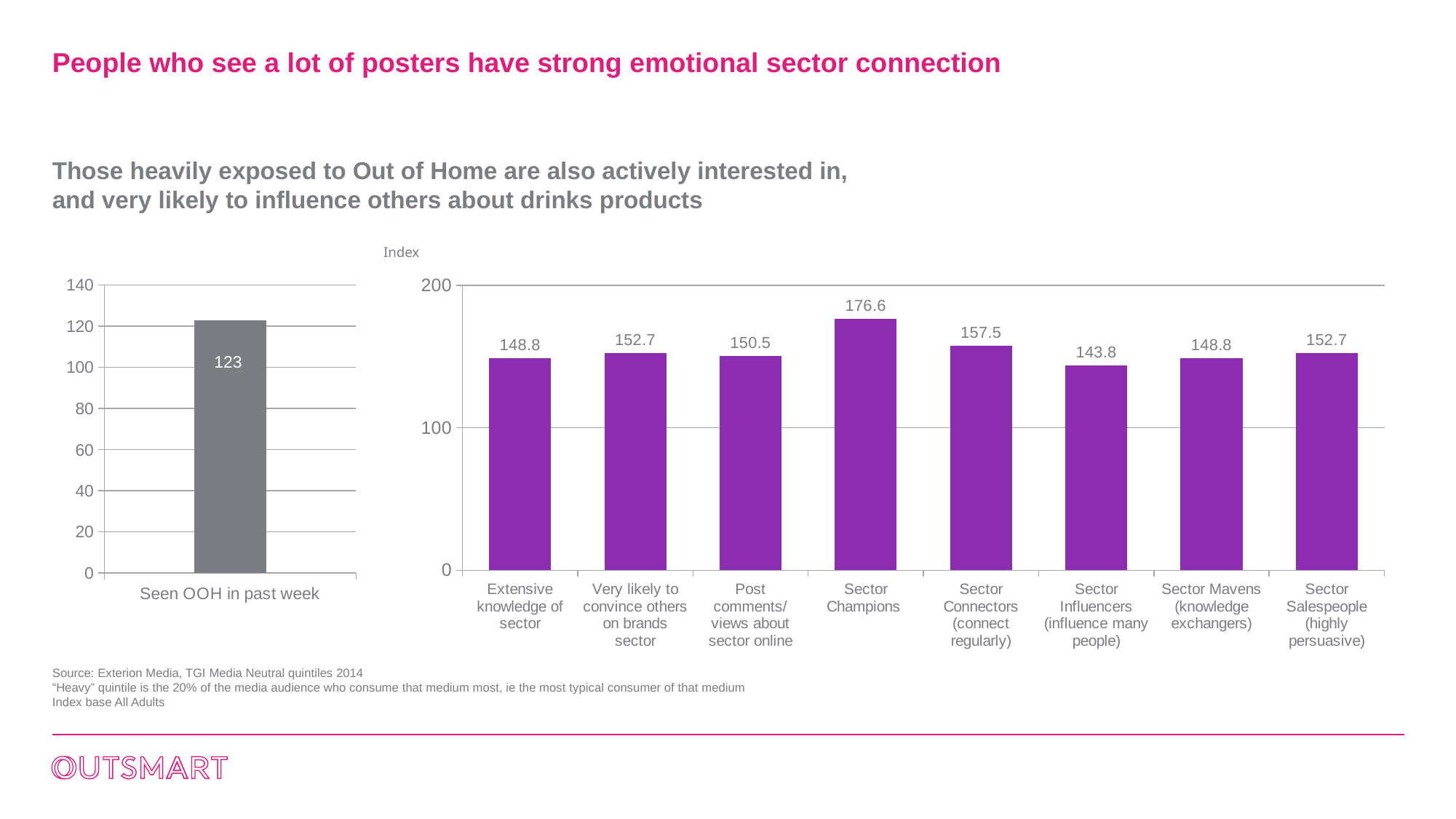
In the right chart, what is the difference between the index values for Sector Champions and Sector Connectors (connect regularly)? 19.1 In the right chart, is the value for Sector Mavens (knowledge exchangers) greater or less than 100? greater In the right chart, which is larger: the index value for Sector Connectors (connect regularly) or for Sector Salespeople (highly persuasive)? Sector Connectors (connect regularly) In the right chart, what is the index value for Sector Influencers (influence many people)? 143.8 In the right chart, what is the index value for Post comments/views about sector online? 150.5 How many categories are shown in the right chart? 8 What kind of chart is the right chart? Bar chart In the right chart, what is the index value for Sector Champions? 176.6 What is the axis label shown above the right chart's vertical axis? Index In the left chart, what is the value for Seen OOH in past week? 123 In the right chart, which category has the lowest index value? Sector Influencers (influence many people) In the right chart, which category has the highest index value? Sector Champions